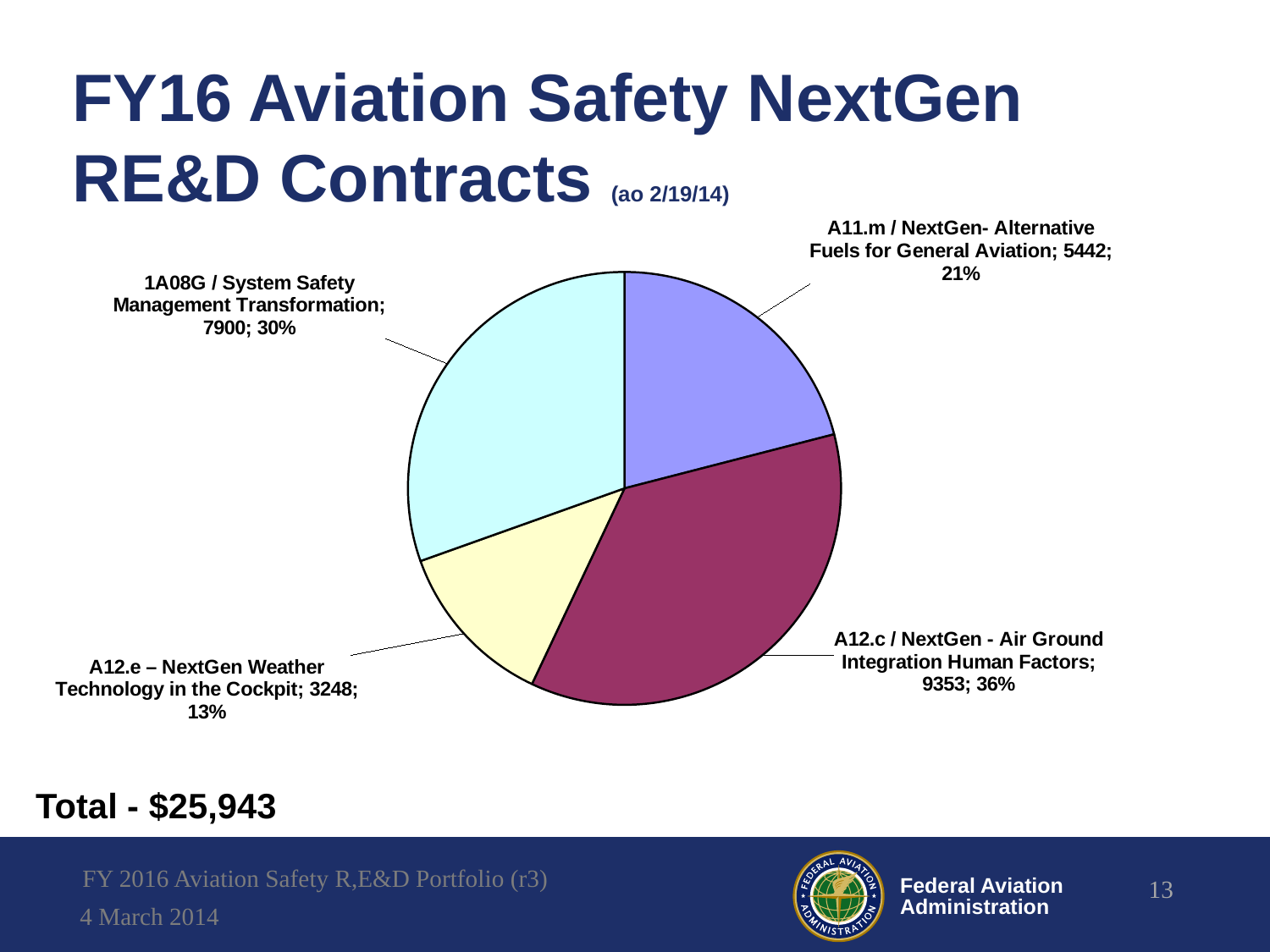
Which category has the largest slice of the pie? A12.c / NextGen - Air Ground Integration Human Factors What is the value for A11.m / NextGen- Alternative Fuels for General Aviation? 5442 What is the value for A12.c / NextGen - Air Ground Integration Human Factors? 9353 How many slices does the pie chart have? 4 What is the value for A12.e – NextGen Weather Technology in the Cockpit? 3248 What share of the pie does A12.e – NextGen Weather Technology in the Cockpit represent? 13% Which category has the smallest slice of the pie? A12.e – NextGen Weather Technology in the Cockpit Which is larger, the value for A11.m / NextGen- Alternative Fuels for General Aviation or A12.e – NextGen Weather Technology in the Cockpit? A11.m / NextGen- Alternative Fuels for General Aviation What kind of chart is shown on the slide? pie chart What is the value for 1A08G / System Safety Management Transformation? 7900 What share of the pie does 1A08G / System Safety Management Transformation represent? 30% What is the difference between the values for A12.c / NextGen - Air Ground Integration Human Factors and 1A08G / System Safety Management Transformation? 1453